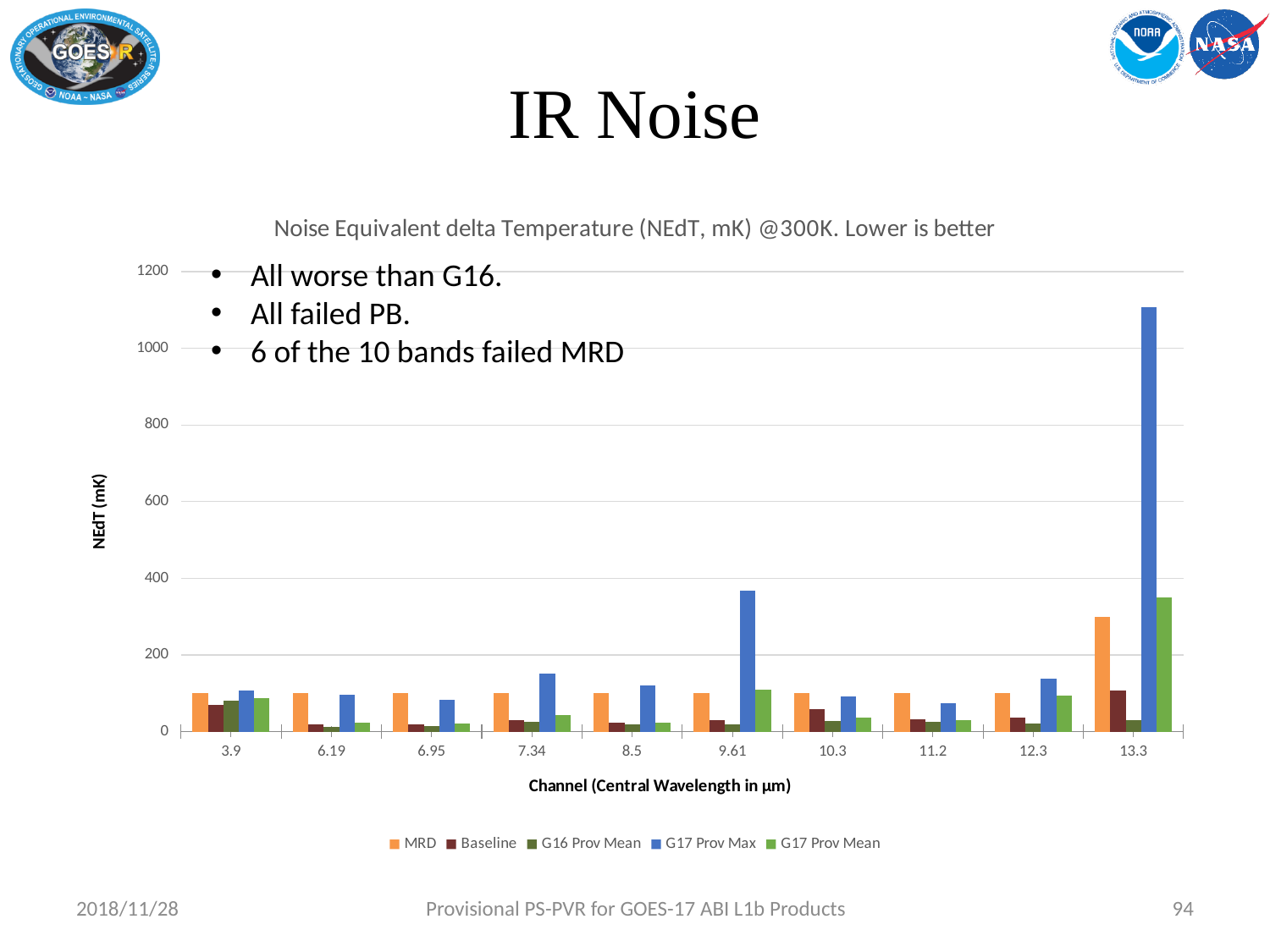
Is the G17 Prov Mean value for channel 13.3 greater or less than 400? less How many series does the chart legend list? 5 Is the G17 Prov Max value for channel 9.61 greater or less than 400? less Is the G17 Prov Max value for channel 9.61 greater or less than 200? greater How many channel categories are shown on the x axis of the chart? 10 What is the label of the y axis of the chart? NEdT (mK) What is the label of the x axis of the chart? Channel (Central Wavelength in μm) What kind of chart is shown on the slide? Bar chart Which channel has the highest G17 Prov Max value? 13.3 Which is larger, the G17 Prov Max value for channel 9.61 or for channel 7.34? 9.61